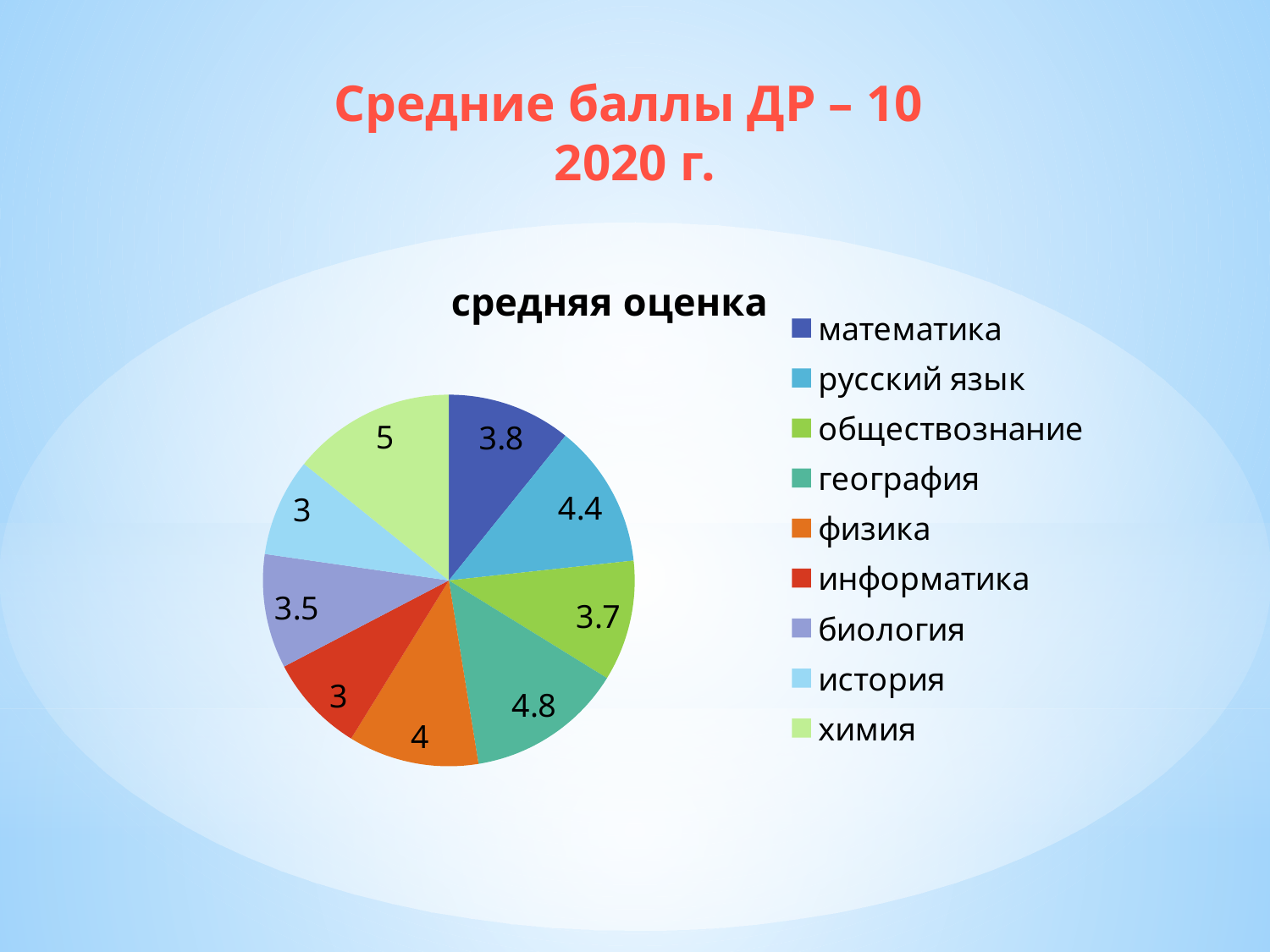
What is the value for математика? 3.8 What kind of chart is shown on the slide? pie chart Which colour represents физика in the legend? orange What is the value for русский язык? 4.4 What is the value for биология? 3.5 What is the value for география? 4.8 Which is larger, the value for физика or the value for русский язык? русский язык What is the difference between the values for география and обществознание? 1.1 How many categories does the legend list? 9 What is the difference between the values for химия and информатика? 2 Which category has the highest value? химия What is the title of the chart? средняя оценка